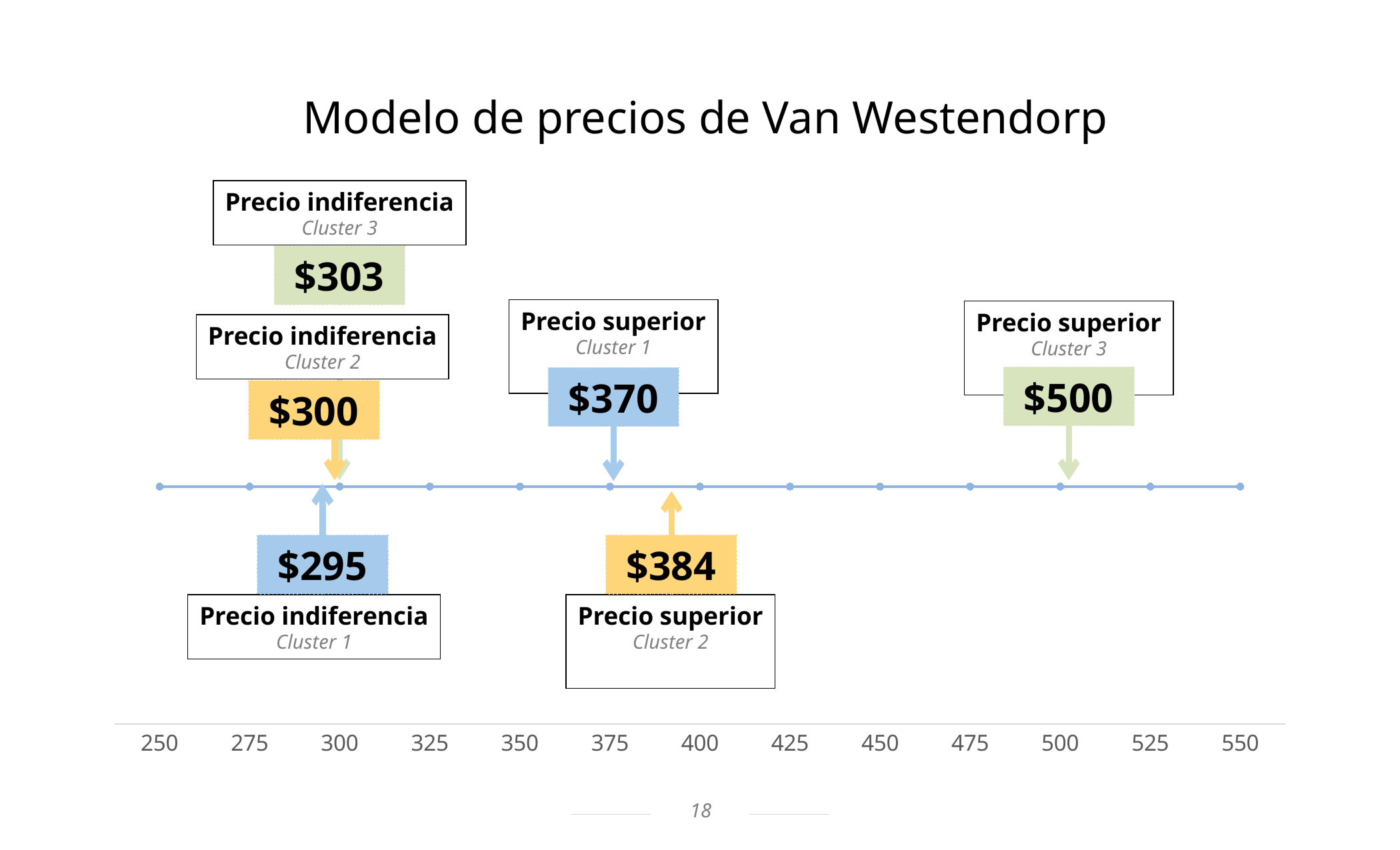
How many price points are marked on the chart? 6 What is the Precio superior for Cluster 3? $500 What is the title of the chart? Modelo de precios de Van Westendorp What is the lowest value shown on the horizontal axis? 250 What is the difference between the Precio superior for Cluster 3 and the Precio superior for Cluster 2? $116 Which cluster has the highest Precio superior? Cluster 3 Which is larger, the Precio indiferencia for Cluster 2 or the Precio indiferencia for Cluster 3? Precio indiferencia for Cluster 3 What is the Precio superior for Cluster 2? $384 What is the Precio indiferencia for Cluster 3? $303 What is the difference between the Precio superior and the Precio indiferencia for Cluster 1? $75 What is the Precio indiferencia for Cluster 1? $295 Which cluster has the lowest Precio indiferencia? Cluster 1